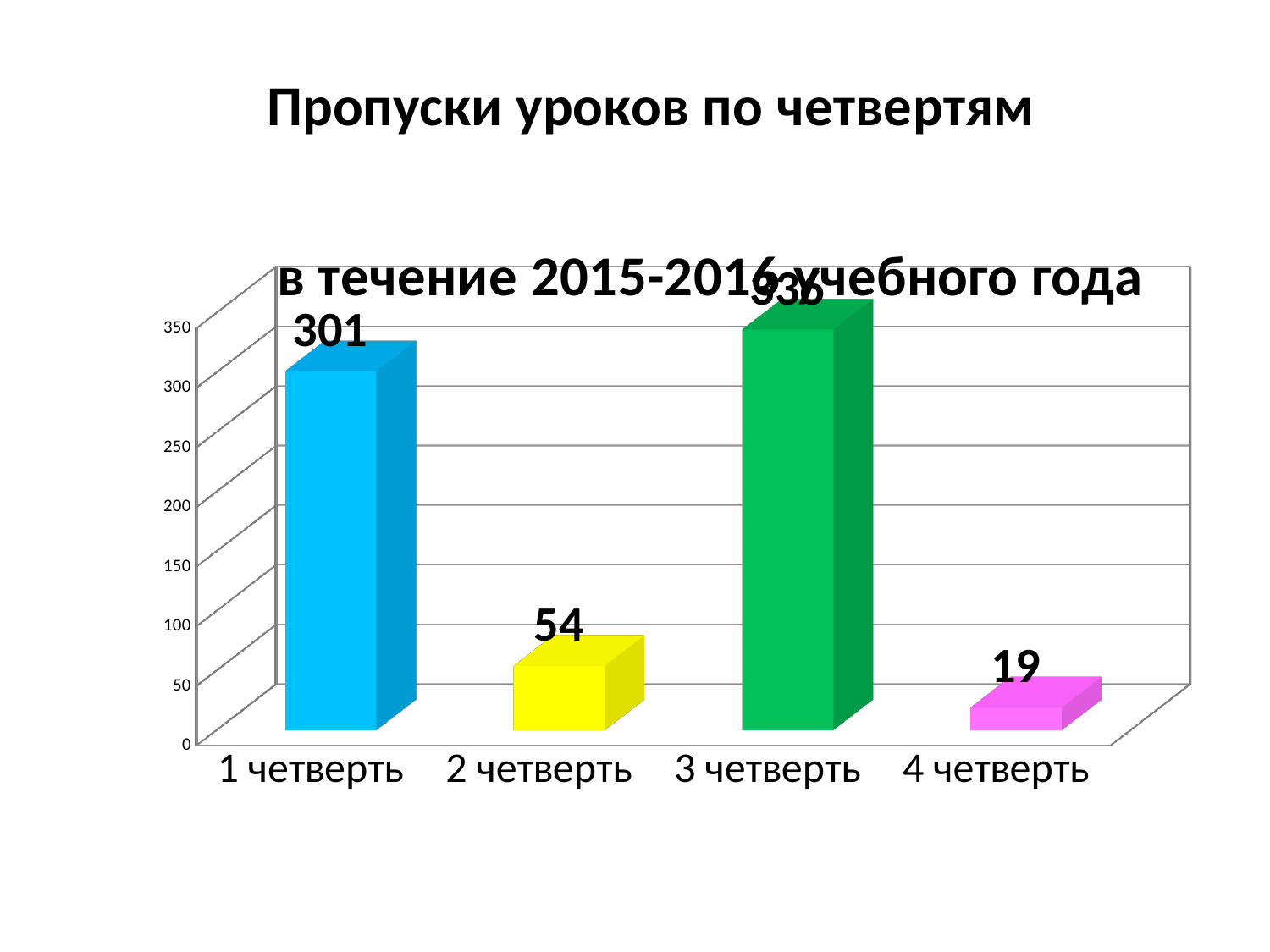
Which quarter has the lowest number of missed lessons? 4 четверть What kind of chart is shown on the slide? bar chart Is the value for 3 четверть greater or less than 300? greater What is the value for 4 четверть? 19 What is the difference between the values for 1 четверть and 2 четверть? 247 What colour is the bar for 2 четверть? yellow Which is larger, the value for 2 четверть or the value for 4 четверть? 2 четверть What is the value for 1 четверть? 301 What is the difference between the values for 2 четверть and 4 четверть? 35 What is the value for 2 четверть? 54 Which quarter has the highest number of missed lessons? 3 четверть How many quarters are shown on the chart? 4